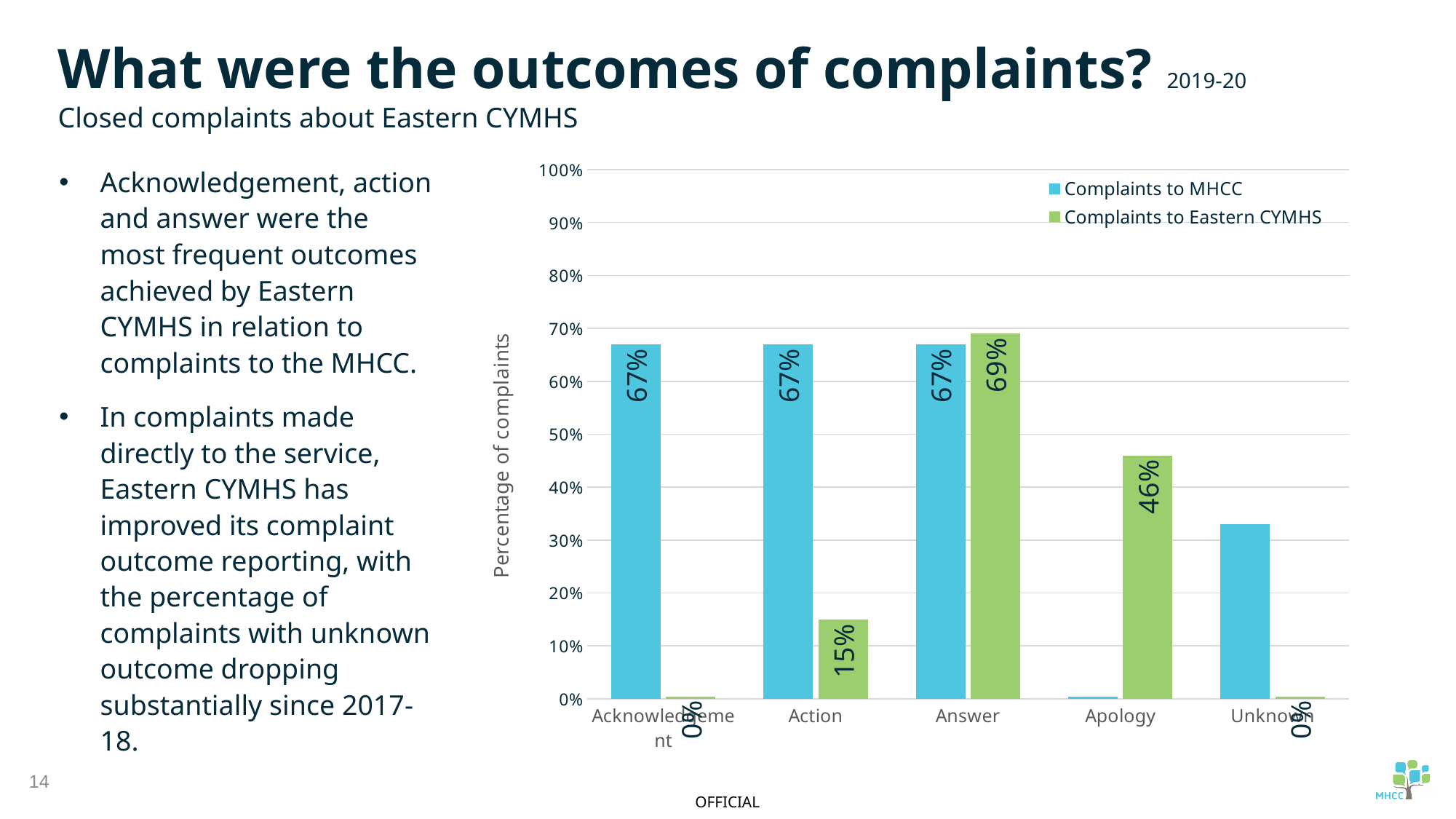
What kind of chart is shown on the slide? bar chart What is the value for Action in the Complaints to Eastern CYMHS series? 15% How many categories are shown on the x axis? 5 For the Answer category, what is the difference between the Complaints to Eastern CYMHS value and the Complaints to MHCC value? 2% What is the difference between the Answer and Action values in the Complaints to Eastern CYMHS series? 54% Which category has the highest value in the Complaints to Eastern CYMHS series? Answer In the Complaints to Eastern CYMHS series, which is larger: Apology or Action? Apology How many series does the legend list? 2 What is the value for Acknowledgement in the Complaints to Eastern CYMHS series? 0% Is the value for Unknown in the Complaints to MHCC series greater or less than 40%? less What is the value for Apology in the Complaints to Eastern CYMHS series? 46% What is the value for Answer in the Complaints to MHCC series? 67%